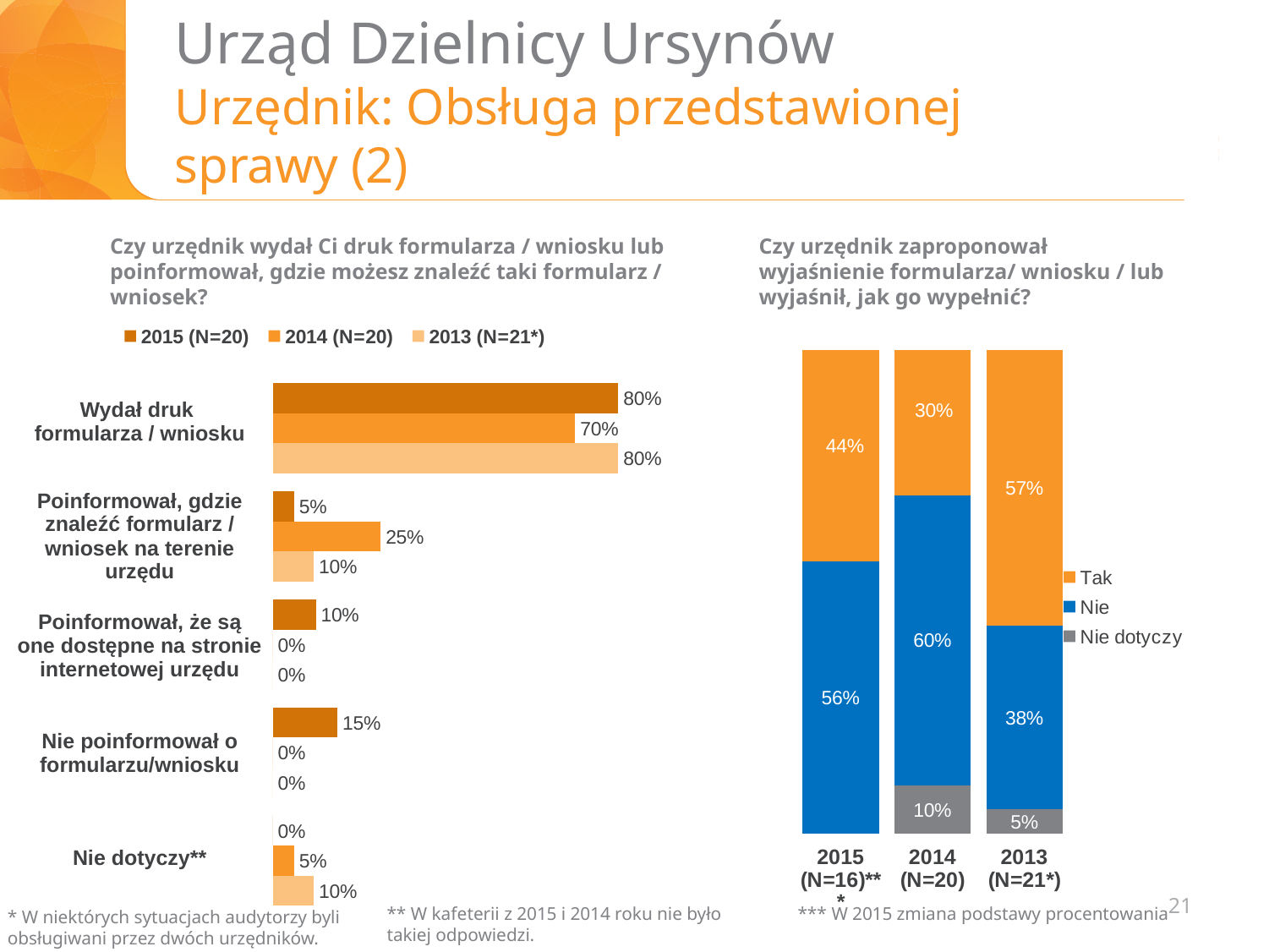
In the right chart, is the 'Nie' share larger for 2015 (N=16)** or for 2013 (N=21*)? 2015 (N=16)** In the right chart, which year has the lowest 'Tak' share? 2014 (N=20) In the right chart, what is the 'Tak' share for 2013 (N=21*)? 57% In the left chart, how many categories are shown on the vertical axis? 5 What type of chart is the left chart? Bar chart In the right chart (Czy urzędnik zaproponował wyjaśnienie formularza...), what is the 'Nie' share for 2014 (N=20)? 60% In the left chart (Czy urzędnik wydał Ci druk formularza...), what is the 2014 (N=20) value for 'Wydał druk formularza / wniosku'? 70% In the left chart, what is the 2014 (N=20) value for 'Poinformował, gdzie znaleźć formularz / wniosek na terenie urzędu'? 25% In the left chart, which category has the highest value for the 2013 (N=21*) series? Wydał druk formularza / wniosku In the left chart, what is the difference between the 2014 and 2015 values for 'Poinformował, gdzie znaleźć formularz / wniosek na terenie urzędu'? 20 percentage points In the left chart, how many series does the legend list? 3 In the left chart, what is the 2015 (N=20) value for 'Nie poinformował o formularzu/wniosku'? 15%